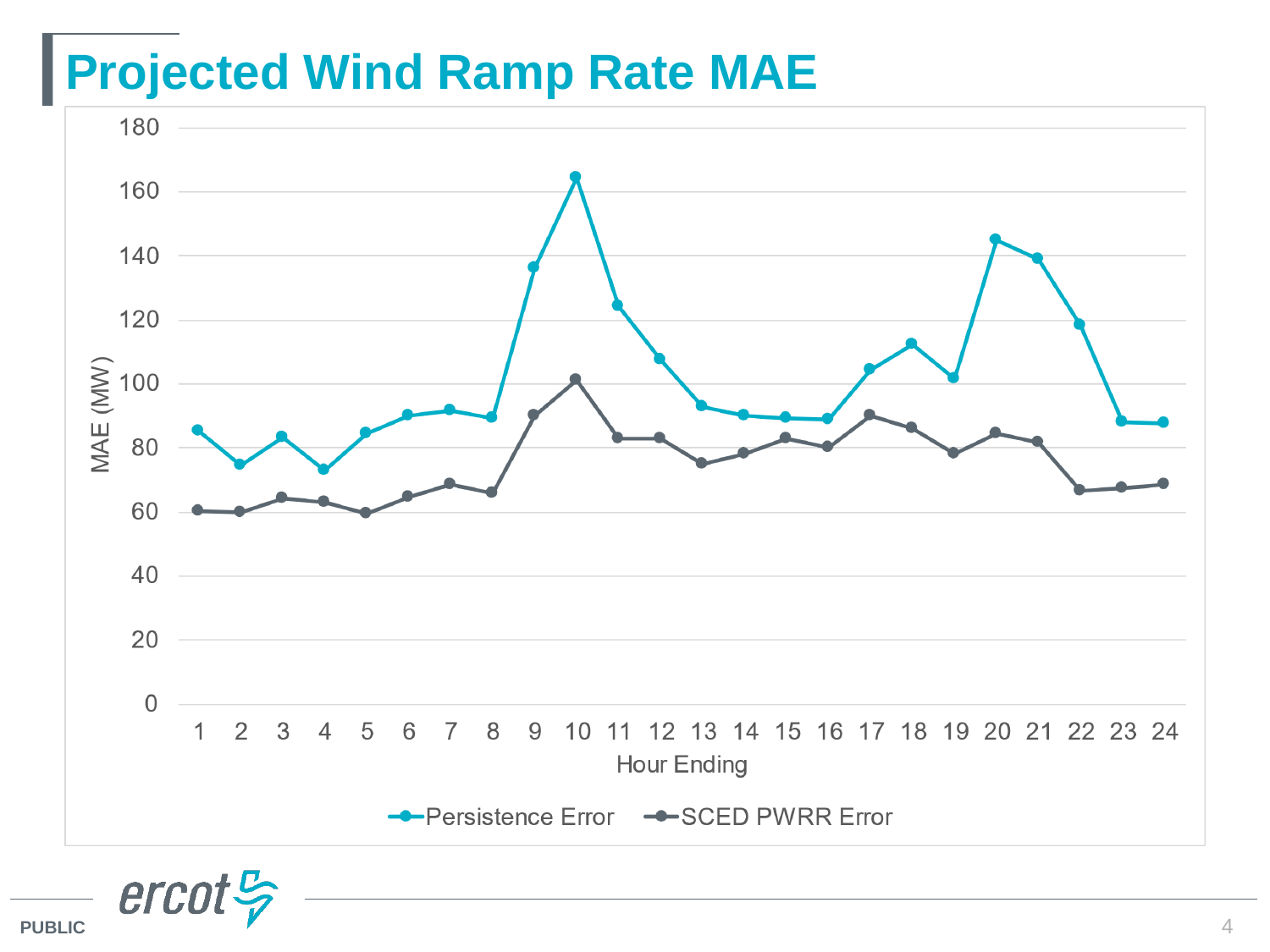
What is the label of the y axis? MAE (MW) Is the Persistence Error at hour ending 10 greater or less than 160? greater Is the Persistence Error at hour ending 4 greater or less than 80? less What kind of chart is shown on the slide? line chart Which series has the larger value at hour ending 20, Persistence Error or SCED PWRR Error? Persistence Error At which hour ending does the SCED PWRR Error reach its highest value? 10 At which hour ending is the Persistence Error lowest? 4 How many series does the legend list? 2 How many hours are plotted along the x axis? 24 At which hour ending does the Persistence Error reach its highest value? 10 Is the SCED PWRR Error at hour ending 13 greater or less than 80? less Does the Persistence Error rise or fall from hour ending 10 to hour ending 13? fall